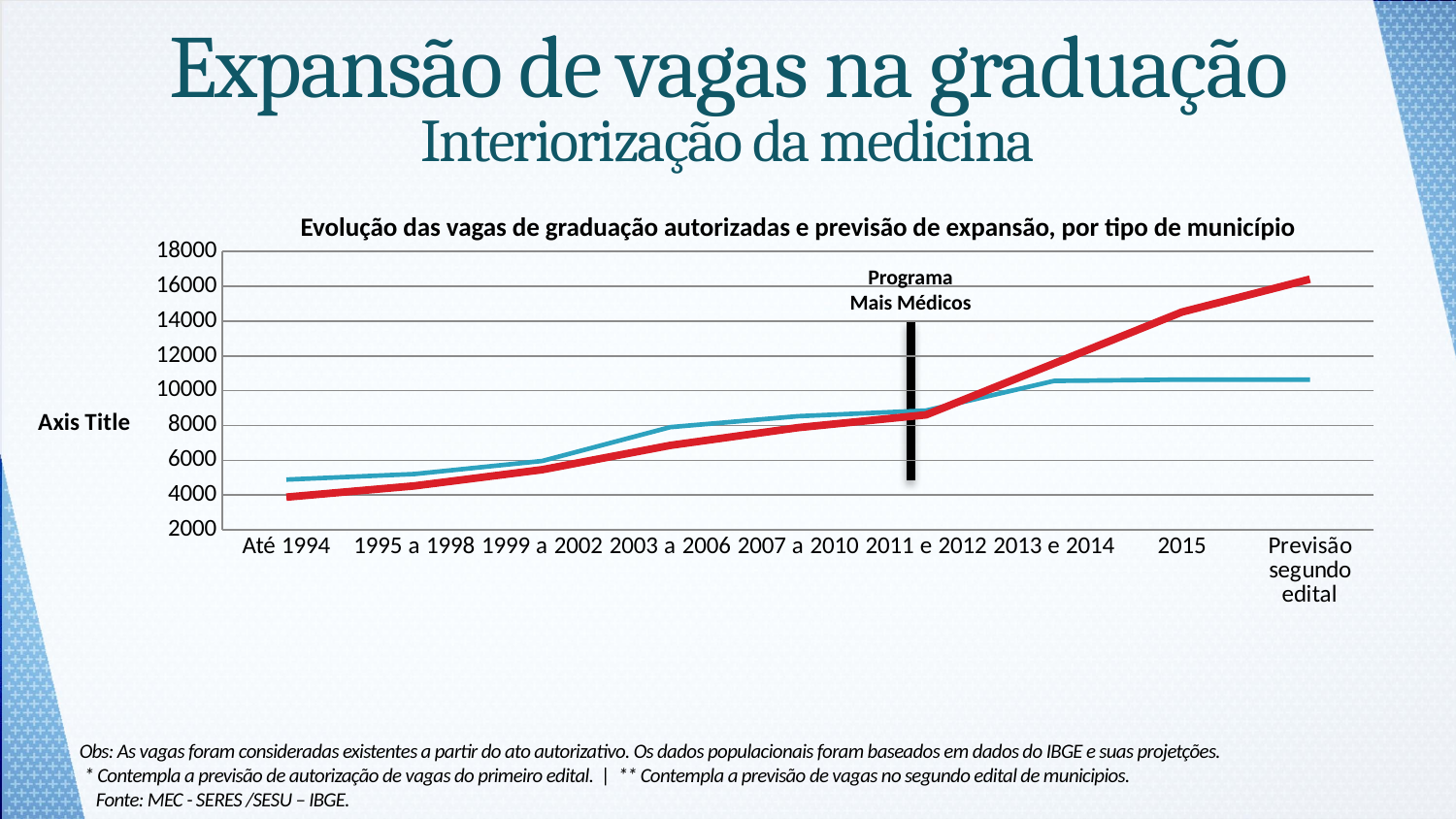
How many lines are plotted on the chart? 2 Is the value of the red line at 'Até 1994' greater or less than 6000? less At which category does the red line have its lowest value? Até 1994 What label is written next to the vertical black bar on the chart? Programa Mais Médicos How many categories are shown on the x axis of the chart? 9 What type of chart is shown on the slide? line chart Is the value of the blue line at 'Previsão segundo edital' greater or less than 10000? greater Does the red line rise or fall from 'Até 1994' to 'Previsão segundo edital'? rise What is the title of the chart? Evolução das vagas de graduação autorizadas e previsão de expansão, por tipo de município Is the value of the red line at 'Previsão segundo edital' greater or less than 14000? greater At which category does the red line reach its highest value? Previsão segundo edital At 'Previsão segundo edital', which line has the higher value, the red line or the blue line? the red line